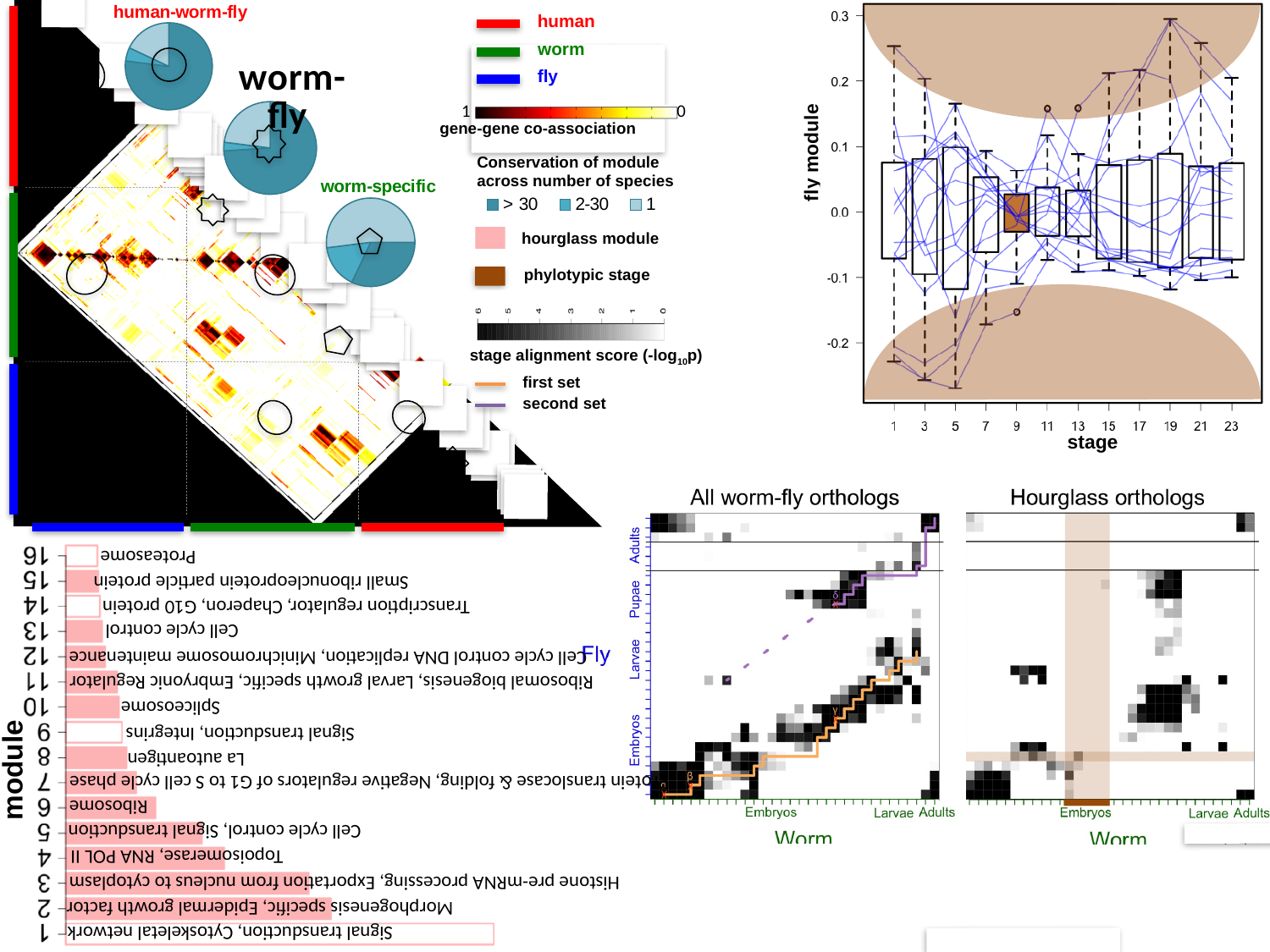
How many conservation categories does the 'Conservation of module across number of species' legend list? 3 In the bottom-left bar chart of fly modules, how many modules are listed? 16 In the top-right box plot, how many stage labels are shown on the x axis? 12 In the bottom-left bar chart of fly modules, what is the label of module 10? Spliceosome In the bottom-left bar chart of fly modules, which module has the longest bar? 1 In the top-right box plot, what is the highest value labeled on the y axis? 0.3 In the top-right box plot, what is the lowest value labeled on the y axis? -0.2 In the bottom-left bar chart of fly modules, is the bar for module 1 longer or shorter than the bar for module 16? longer In the bottom-left bar chart of fly modules, what is the label of module 16? Proteasome What kind of chart is the top-right plot of fly module against stage? box plot What are the titles of the two heatmaps at the bottom right of the slide? All worm-fly orthologs; Hourglass orthologs In the bottom-left bar chart of fly modules, what is the label of module 6? Ribosome